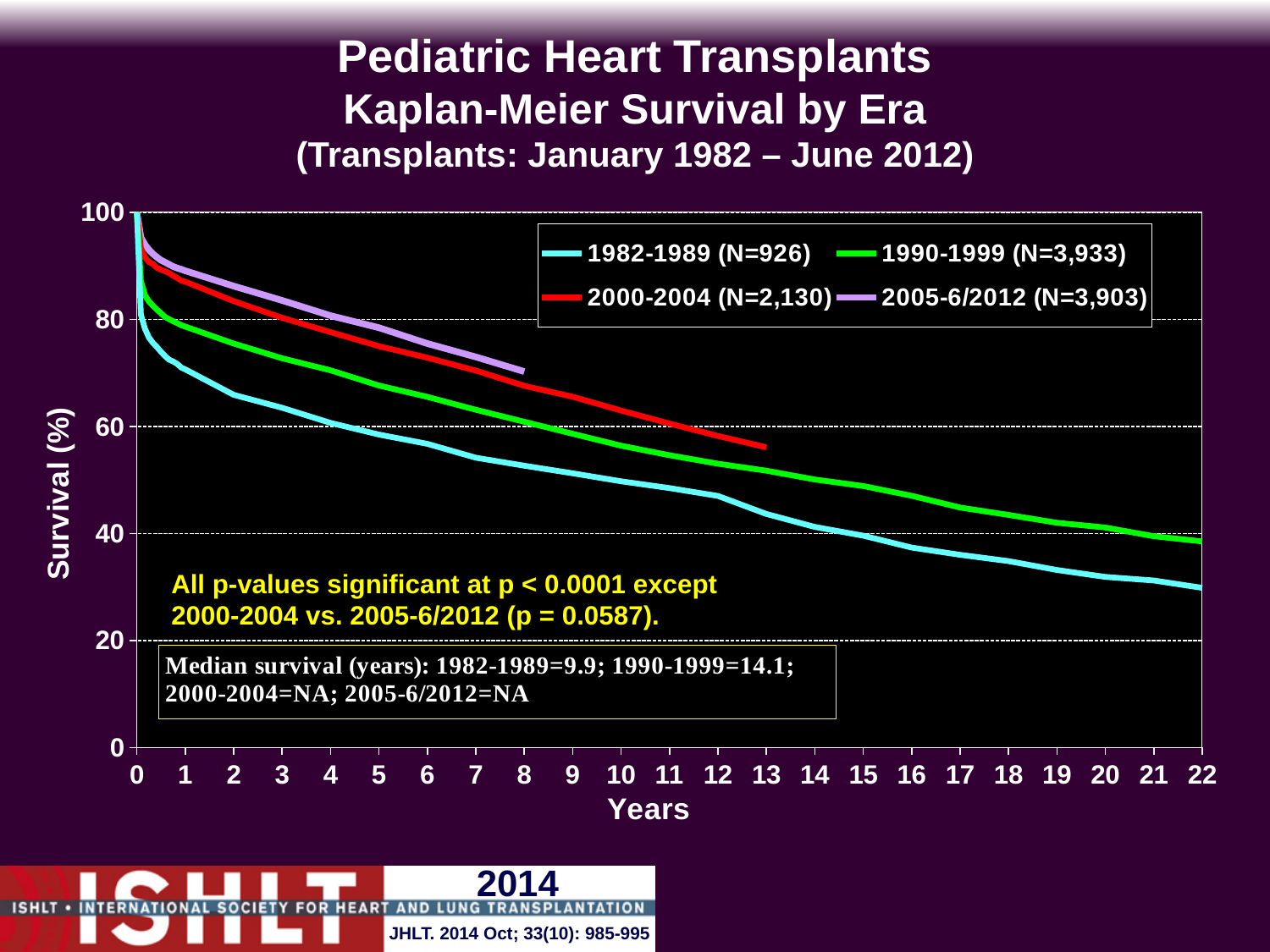
Is the survival for the 1982-1989 era at 22 years greater or less than 40? less What kind of chart is shown on the slide? line chart Is the survival for the 2000-2004 era at 13 years greater or less than 60? less Which era has the lowest survival at 10 years? 1982-1989 Is the survival for the 2005-6/2012 era at 8 years greater or less than 60? greater Which era has the highest survival at 8 years? 2005-6/2012 Does survival rise or fall as the number of years increases? fall What is the median survival in years for the 1990-1999 era, as printed on the slide? 14.1 What is the number of transplants (N) shown in the legend for the 1982-1989 era? 926 What is the number of transplants (N) shown in the legend for the 2005-6/2012 era? 3,903 What is the median survival in years for the 1982-1989 era, as printed on the slide? 9.9 How many series does the legend list? 4